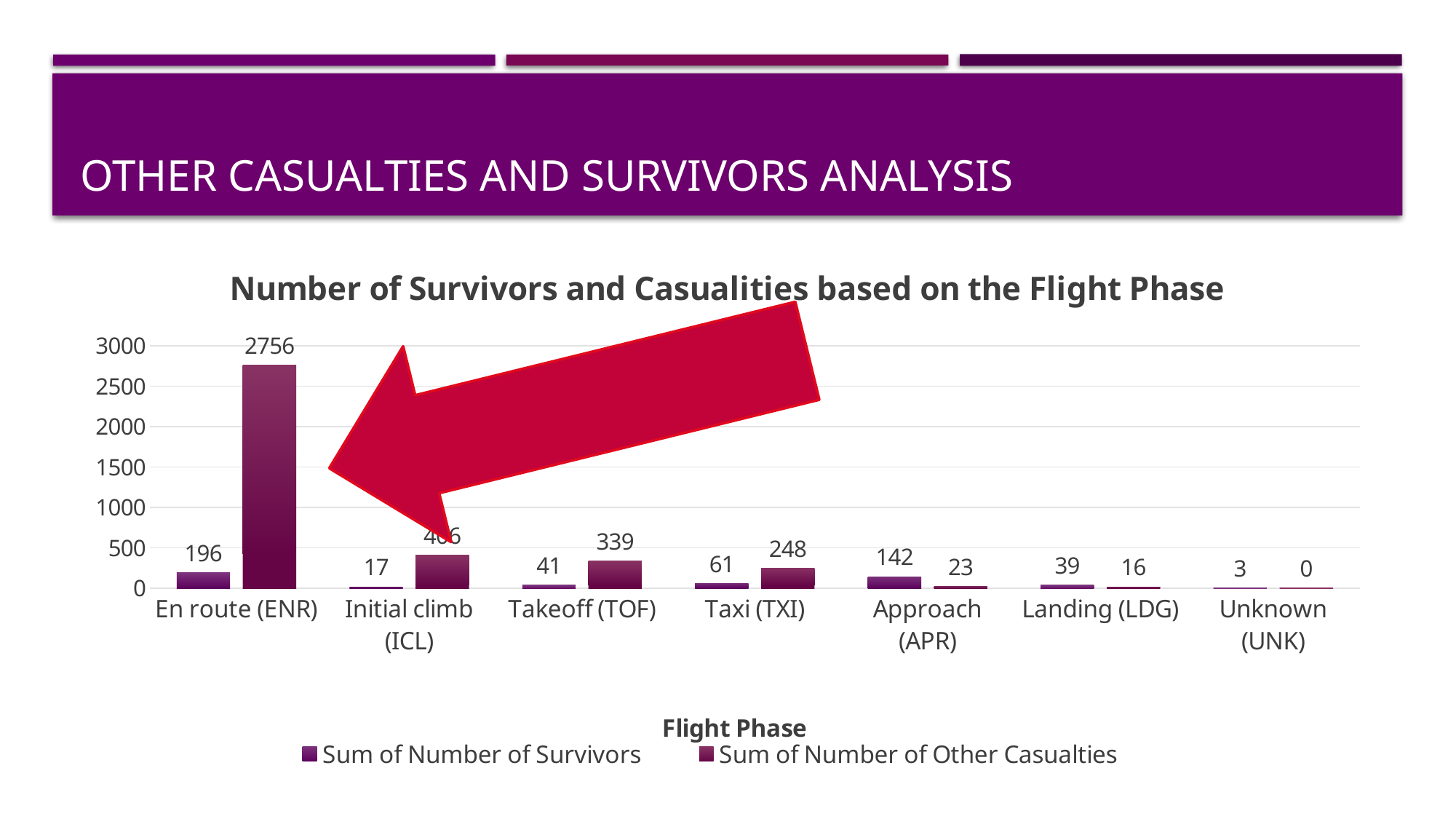
What is the Sum of Number of Other Casualties for En route (ENR)? 2756 What is the Sum of Number of Survivors for Approach (APR)? 142 What type of chart is shown on the slide? Bar chart What is the Sum of Number of Other Casualties for Taxi (TXI)? 248 Is the Sum of Number of Other Casualties for En route (ENR) greater or less than 2500? greater For Approach (APR), which is larger: the Sum of Number of Survivors or the Sum of Number of Other Casualties? Sum of Number of Survivors What is the difference between the Sum of Number of Other Casualties and the Sum of Number of Survivors for Takeoff (TOF)? 298 How many flight phases are shown on the x axis? 7 Which flight phase has the lowest Sum of Number of Survivors? Unknown (UNK) What is the Sum of Number of Survivors for Unknown (UNK)? 3 How many series does the legend list? 2 Which flight phase has the highest Sum of Number of Other Casualties? En route (ENR)